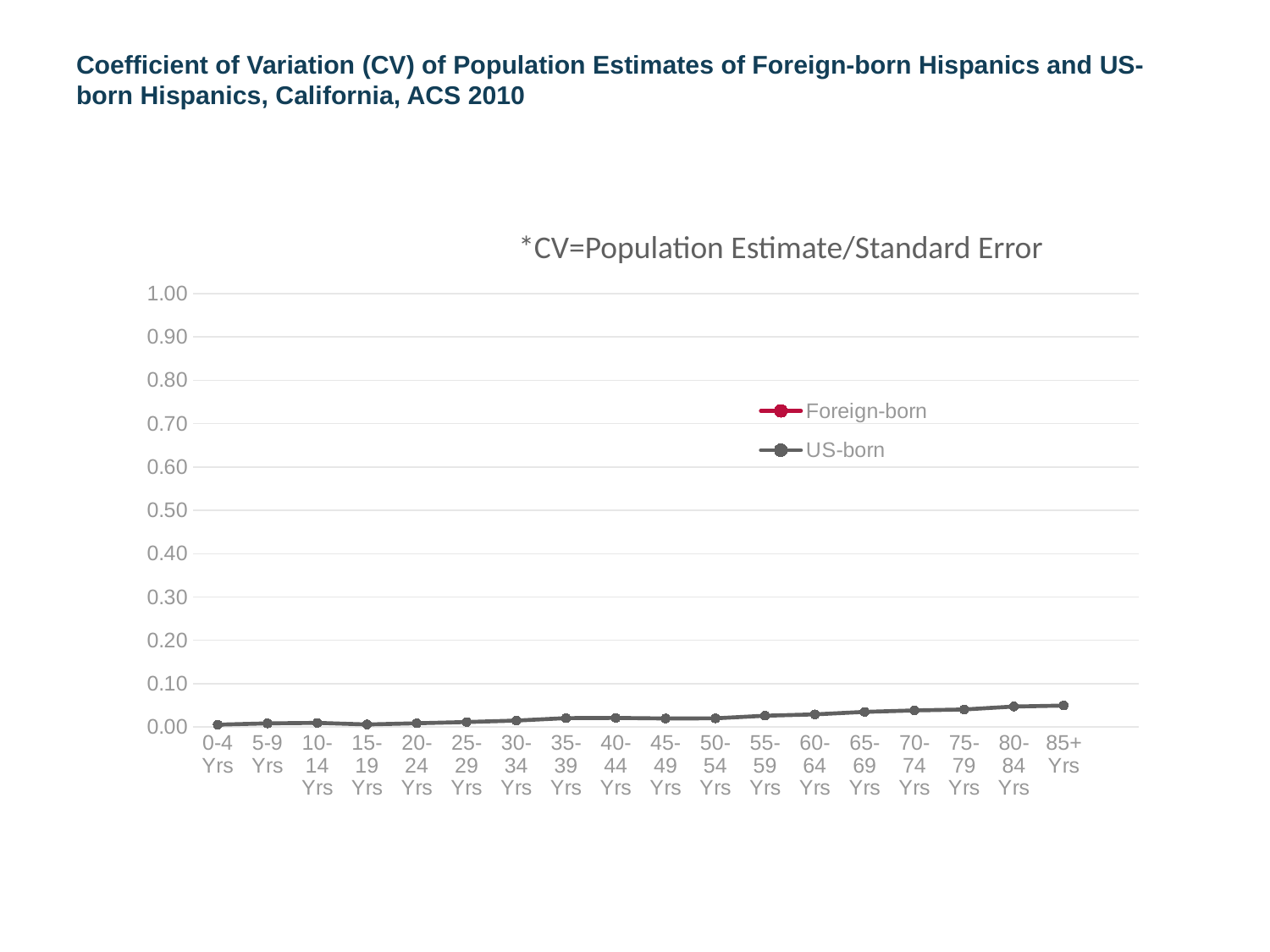
What kind of chart is shown on the slide? line chart Do the US-born values generally rise or fall as age increases along the x axis? rise What is the highest value shown on the y axis? 1.00 What is the first age-group category on the x axis? 0-4 Yrs Is the US-born value for 50-54 Yrs greater or less than 0.50? less Is the US-born value for 85+ Yrs greater or less than 0.10? less How many age-group categories are shown on the x axis? 18 Which series is shown in red in the legend? Foreign-born Is the US-born value for 0-4 Yrs greater or less than 0.10? less How many series does the legend list? 2